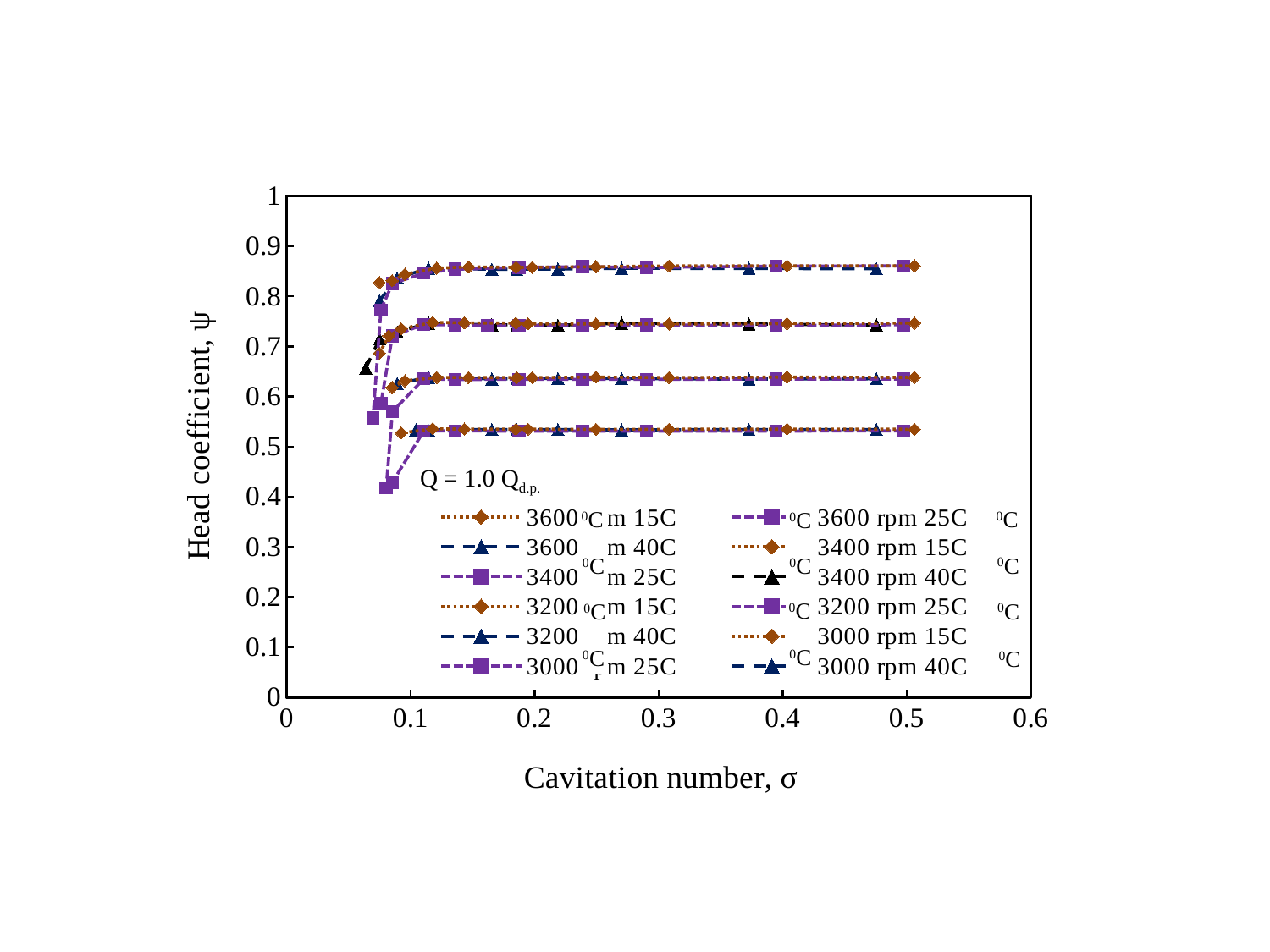
What is the label of the x axis? Cavitation number, σ What is the maximum value shown on the x axis? 0.6 What kind of chart is shown on the slide? line chart How many series does the legend list? 12 Is the head coefficient of the lowest group of curves at a cavitation number of 0.4 greater or less than 0.5? greater Do the head coefficient values rise, fall, or stay roughly flat as the cavitation number increases from 0.2 to 0.5? stay roughly flat Is the head coefficient of the second-highest group of curves at a cavitation number of 0.4 greater or less than 0.7? greater Is the head coefficient of the second-lowest group of curves at a cavitation number of 0.2 greater or less than 0.7? less Do the head coefficient values rise or fall as the cavitation number increases from about 0.08 to about 0.12? rise What is the label of the y axis? Head coefficient, ψ